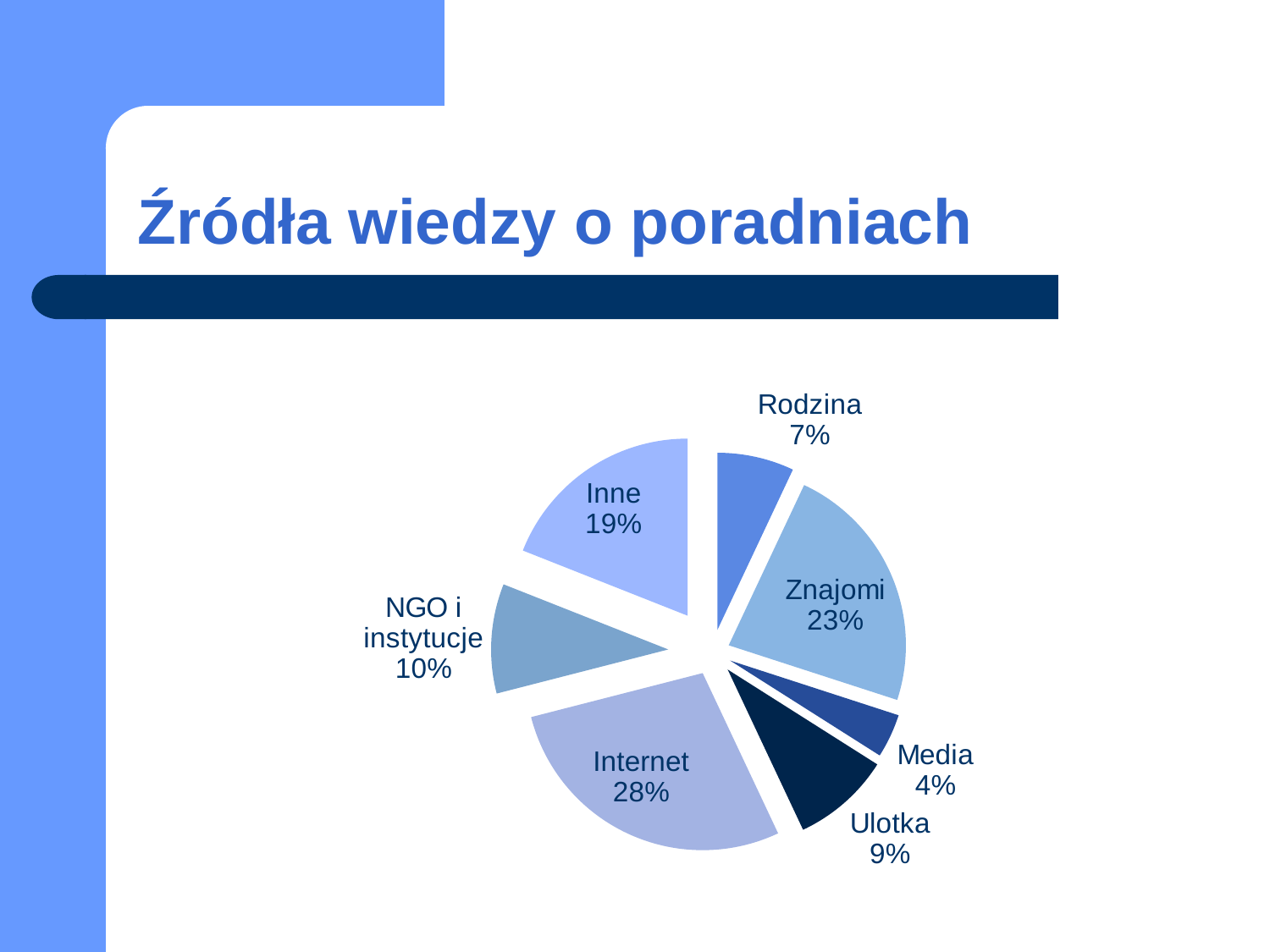
What is the value shown for NGO i instytucje? 10% What is the value shown for Znajomi? 23% Which is larger, the share for Inne or the share for Ulotka? Inne What kind of chart is shown on the slide? Pie chart What share of the pie does Internet account for? 28% What is the title of the slide containing the chart? Źródła wiedzy o poradniach Which category has the smallest slice of the pie? Media How many categories are shown in the pie chart? 7 What is the combined share of Rodzina and Media? 11% What is the value shown for Ulotka? 9% What is the difference between the Internet and Znajomi shares? 5% Which category has the largest slice of the pie? Internet